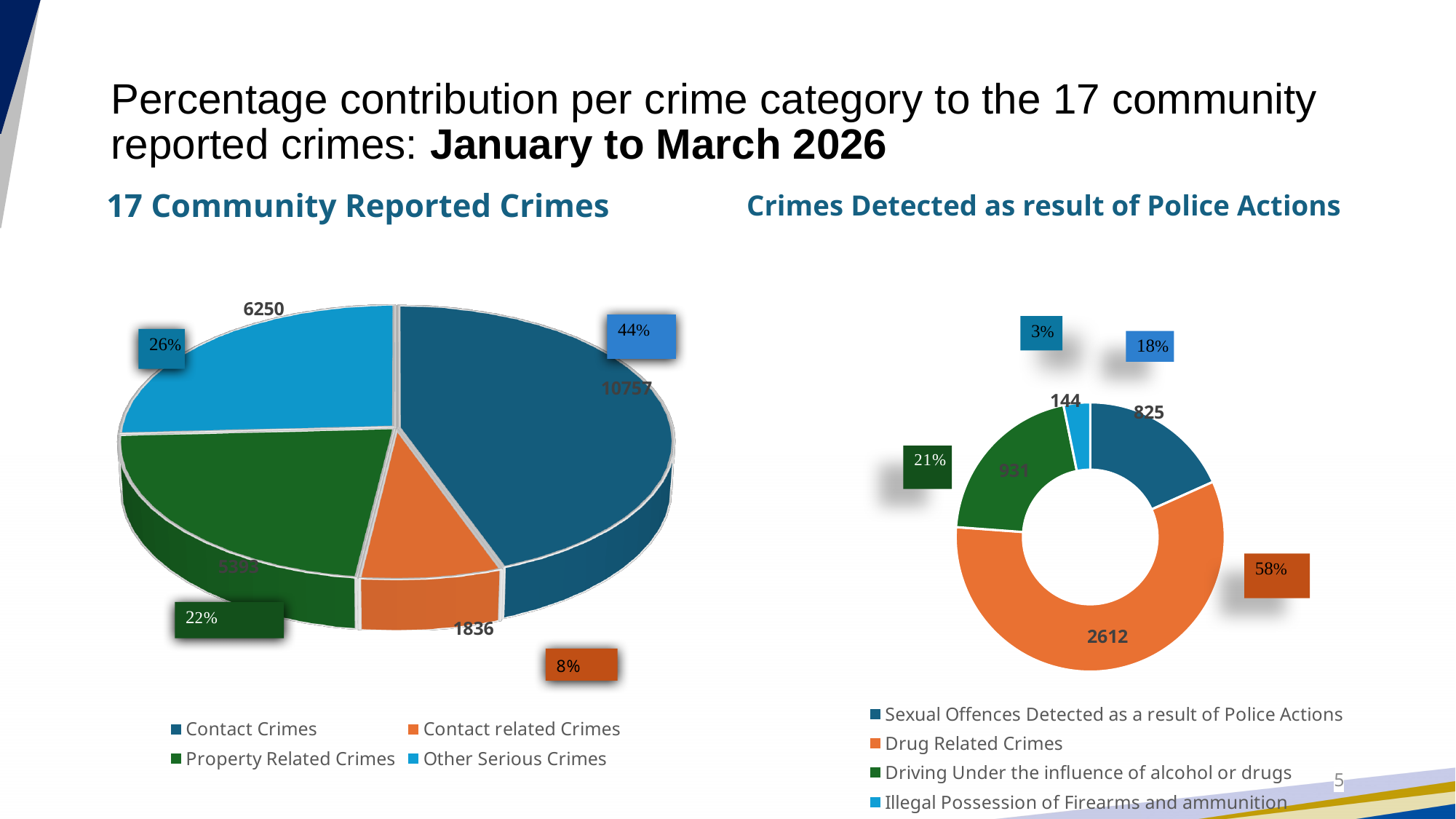
How many categories does the legend of the 'Crimes Detected as result of Police Actions' chart list? 4 In the '17 Community Reported Crimes' chart, what percentage is shown for Contact Crimes? 44% What kind of chart is the 'Crimes Detected as result of Police Actions' chart? Doughnut chart In the '17 Community Reported Crimes' chart, which category has the largest share? Contact Crimes In the '17 Community Reported Crimes' chart, which category has the smallest share? Contact related Crimes In the '17 Community Reported Crimes' chart, what value is shown for Contact related Crimes? 1836 In the '17 Community Reported Crimes' chart, what value is shown for Other Serious Crimes? 6250 In the 'Crimes Detected as result of Police Actions' chart, what is the difference between the values for Drug Related Crimes and Sexual Offences Detected as a result of Police Actions? 1787 In the '17 Community Reported Crimes' chart, what is the difference between the values for Other Serious Crimes and Contact related Crimes? 4414 In the 'Crimes Detected as result of Police Actions' chart, what percentage is shown for Driving Under the influence of alcohol or drugs? 21% In the 'Crimes Detected as result of Police Actions' chart, which category has the smallest value? Illegal Possession of Firearms and ammunition In the 'Crimes Detected as result of Police Actions' chart, what value is shown for Drug Related Crimes? 2612